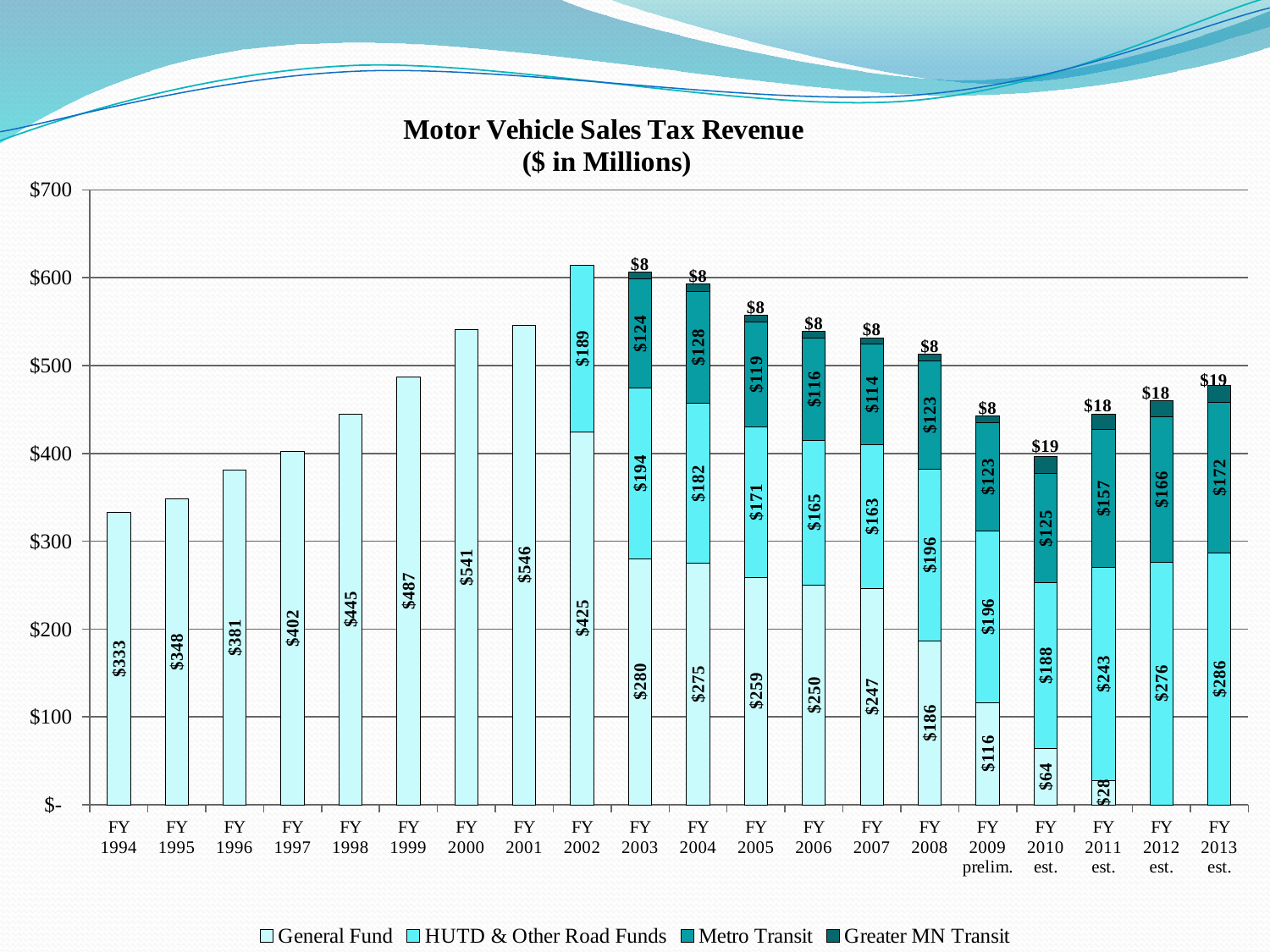
What is the General Fund value for FY 2000? $541 What is the Greater MN Transit value for FY 2010 est.? $19 What is the HUTD & Other Road Funds value for FY 2003? $194 What is the Metro Transit value for FY 2004? $128 In which fiscal year is the General Fund value highest? FY 2001 Which is larger, the Metro Transit value for FY 2005 or for FY 2006? FY 2005 What is the total of the stacked bar for FY 2002? $614 What is the difference between the General Fund values for FY 2003 and FY 2008? $94 How many fiscal years are shown on the x axis? 20 What kind of chart is shown on the slide? Stacked bar chart How many series does the legend list? 4 Do the General Fund values rise or fall from FY 1994 to FY 2001? Rise